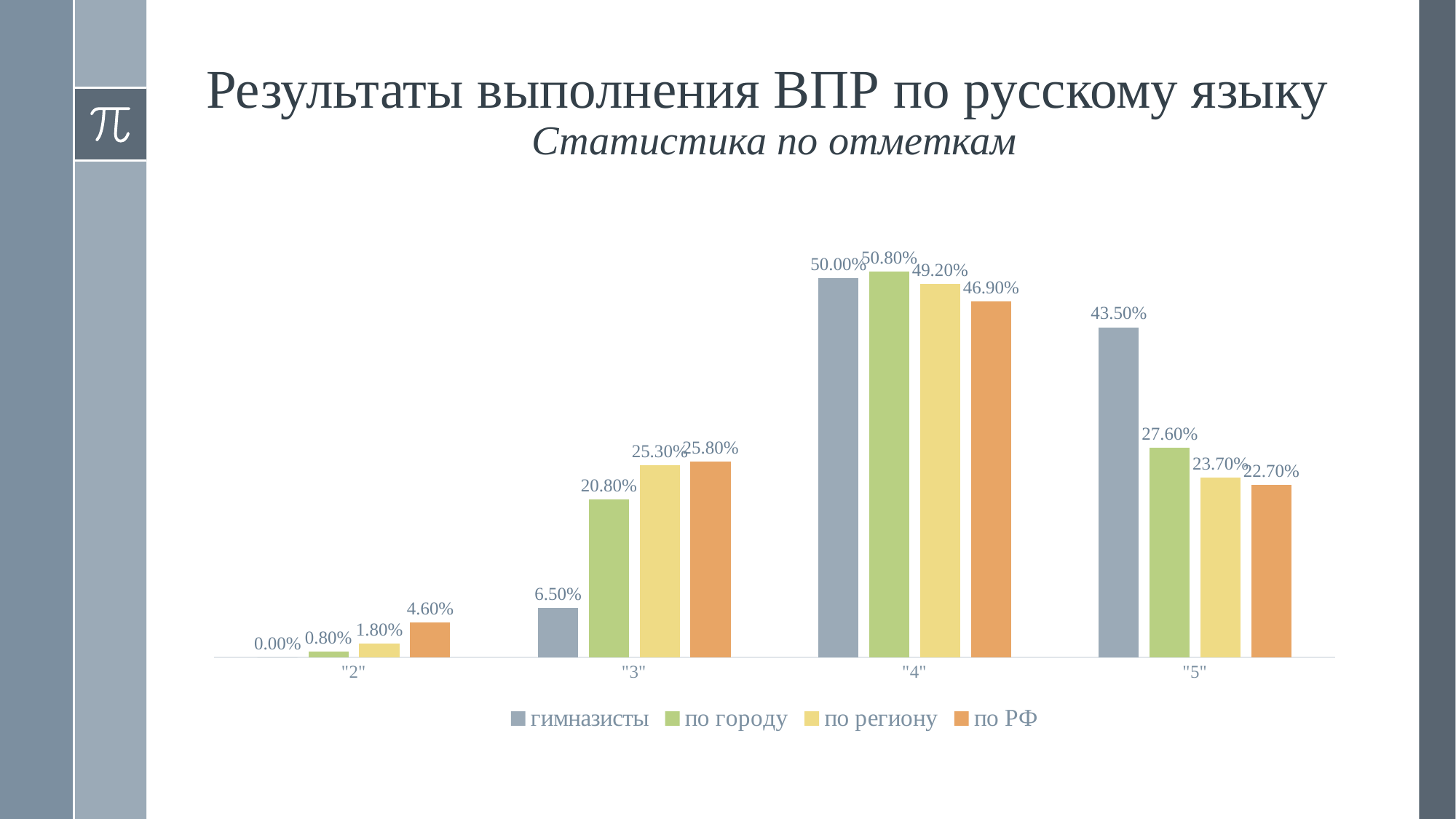
How many series does the legend list? 4 What is the difference between гимназисты and по РФ in category "5"? 20.80% What is the value for по региону in category "4"? 49.20% In which category does the гимназисты series reach its highest value? "4" What is the value for гимназисты in category "5"? 43.50% Which is larger in category "3": гимназисты or по городу? по городу What is the value for по городу in category "2"? 0.80% How many categories are shown on the x axis? 4 What kind of chart is shown on the slide? bar chart In which category does the по РФ series have its lowest value? "2" What is the value for по РФ in category "3"? 25.80% What is the subtitle of the slide below the main title? Статистика по отметкам